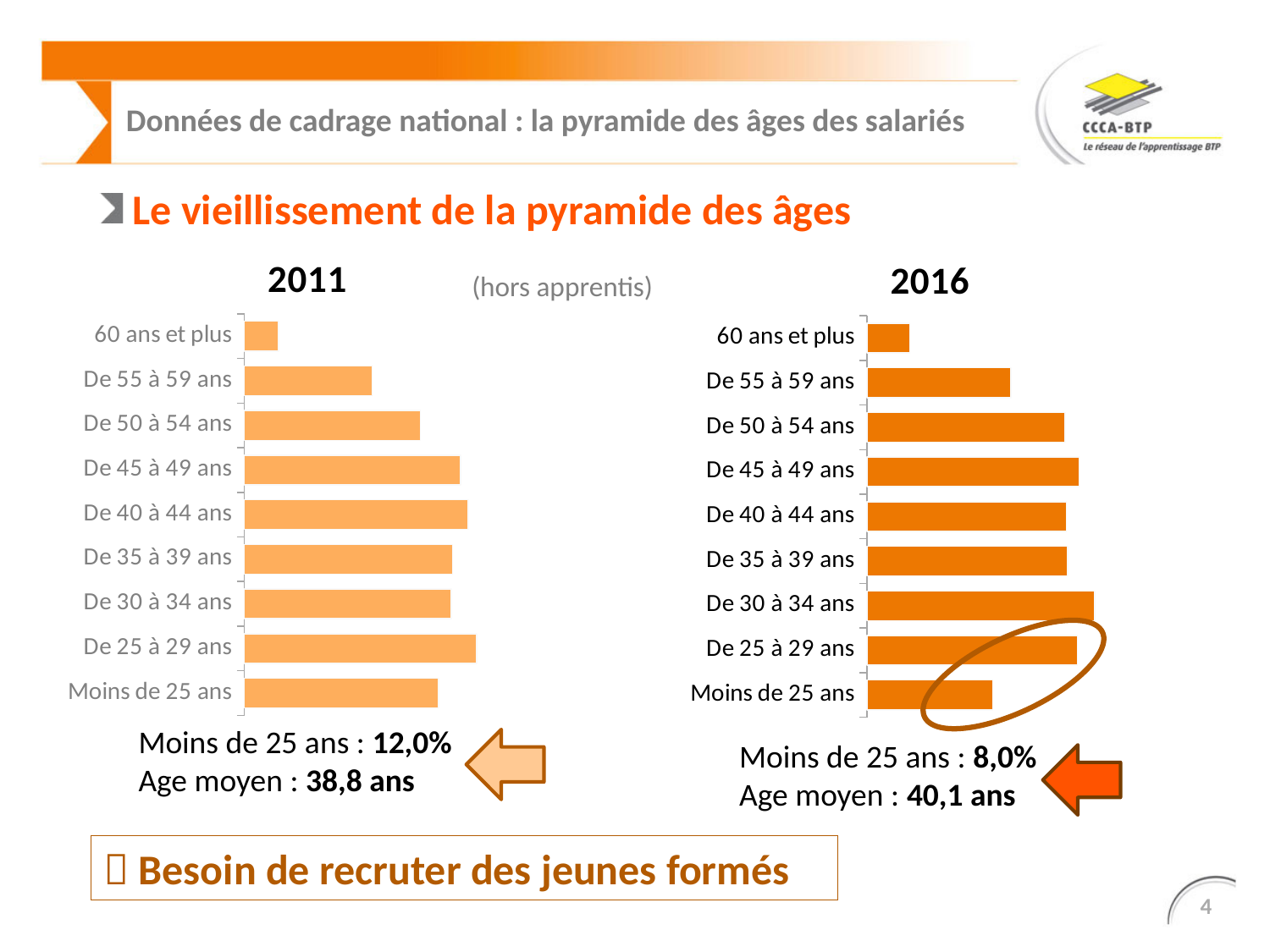
What kind of chart is the 2011 chart? bar chart What is the title of the chart on the left? 2011 In the 2016 chart, which is larger: Moins de 25 ans or De 25 à 29 ans? De 25 à 29 ans In the 2016 chart, which is larger: De 30 à 34 ans or De 55 à 59 ans? De 30 à 34 ans According to the slide, what share of salariés were Moins de 25 ans in 2011? 12,0% In the 2011 chart, which age category has the shortest bar? 60 ans et plus By how many percentage points did the share of Moins de 25 ans fall between 2011 and 2016? 4,0 According to the slide, what share of salariés were Moins de 25 ans in 2016? 8,0% In the 2016 chart, which age category has the shortest bar? 60 ans et plus What note appears between the two chart titles? (hors apprentis) In the 2011 chart, which is larger: De 55 à 59 ans or De 50 à 54 ans? De 50 à 54 ans How many age categories does the 2016 chart show? 9